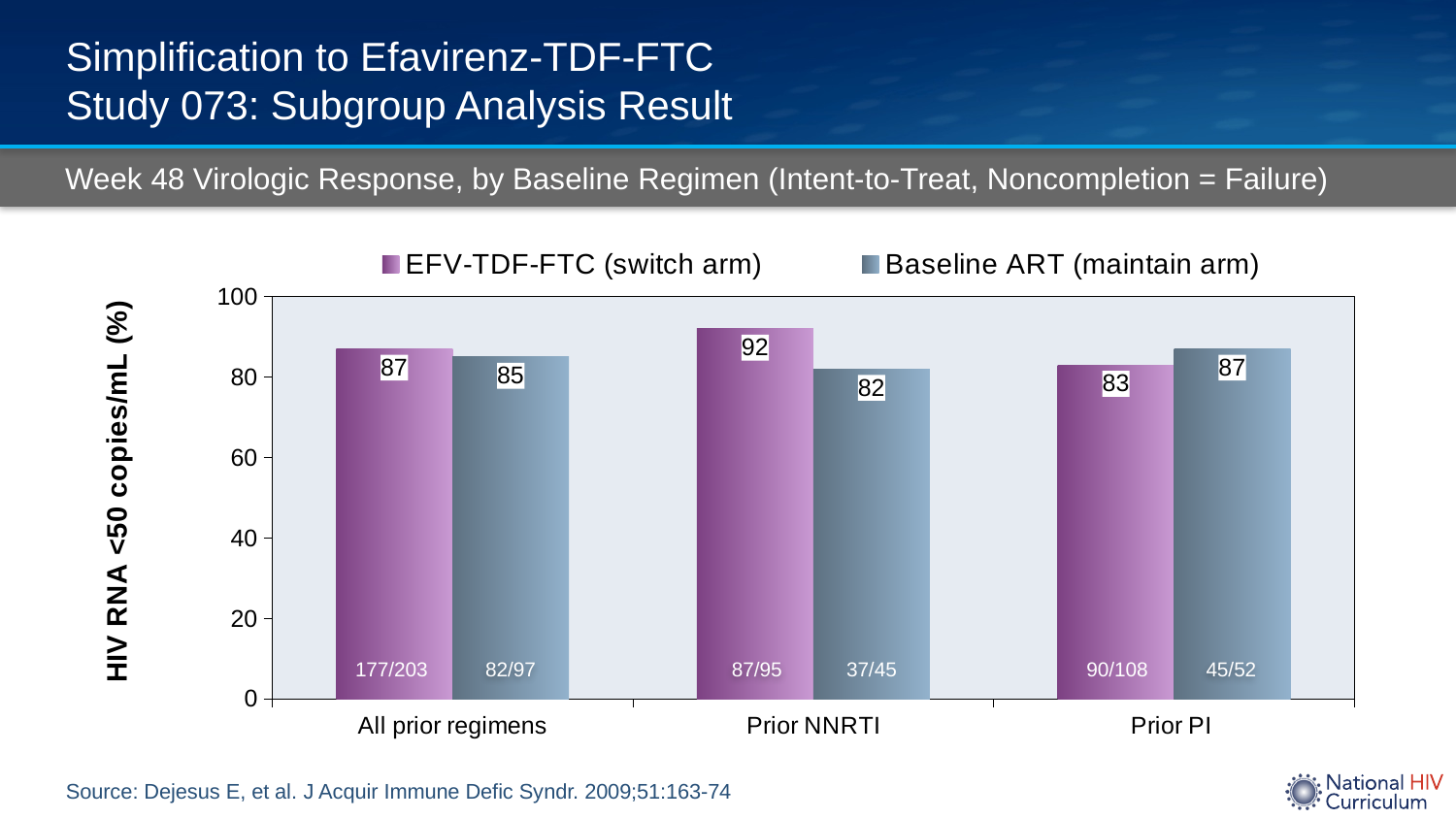
What is the value for Baseline ART (maintain arm) in the All prior regimens group? 85 Which group has the lowest value for Baseline ART (maintain arm)? Prior NNRTI Is the value for EFV-TDF-FTC (switch arm) in the Prior NNRTI group greater or less than 80? greater What is the value for EFV-TDF-FTC (switch arm) in the Prior NNRTI group? 92 What kind of chart is shown on the slide? Bar chart How many series does the legend list? 2 What is the label of the y axis? HIV RNA <50 copies/mL (%) In the Prior PI group, which arm has the larger value, EFV-TDF-FTC (switch arm) or Baseline ART (maintain arm)? Baseline ART (maintain arm) What is the value for Baseline ART (maintain arm) in the Prior PI group? 87 How many baseline regimen groups are shown on the x axis? 3 Which group has the highest value for EFV-TDF-FTC (switch arm)? Prior NNRTI What is the difference between the EFV-TDF-FTC (switch arm) and Baseline ART (maintain arm) values in the Prior NNRTI group? 10